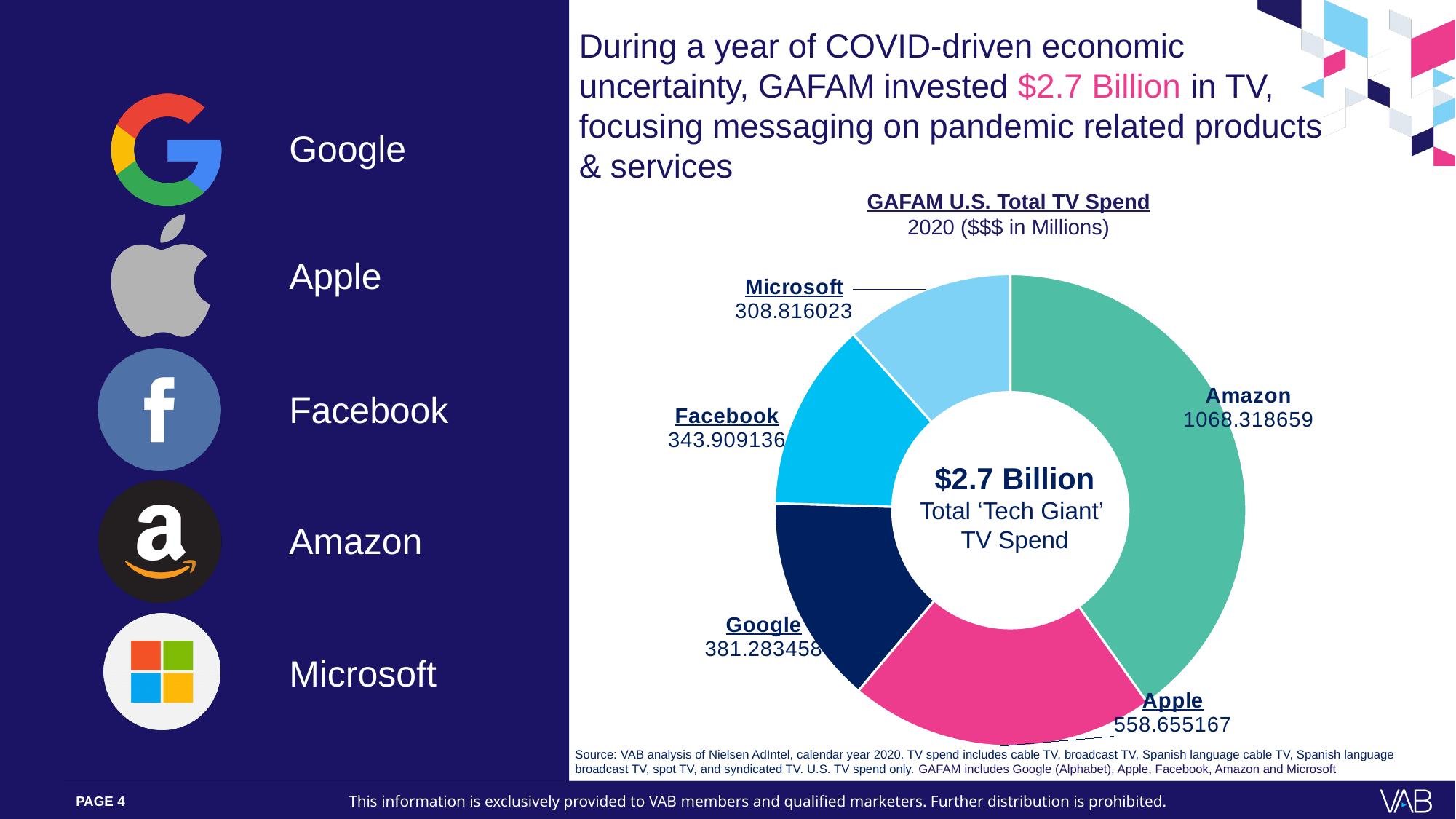
What is the value for Apple in the GAFAM U.S. Total TV Spend chart? 558.655167 Which company has the lowest TV spend in the GAFAM U.S. Total TV Spend chart? Microsoft How many companies are shown in the GAFAM U.S. Total TV Spend chart? 5 What is the value for Amazon in the GAFAM U.S. Total TV Spend chart? 1068.318659 What is the difference between Amazon's and Apple's values in the GAFAM U.S. Total TV Spend chart? 509.663492 What is the difference between Google's and Facebook's values in the GAFAM U.S. Total TV Spend chart? 37.374322 What is the value for Microsoft in the GAFAM U.S. Total TV Spend chart? 308.816023 Which is larger in the GAFAM U.S. Total TV Spend chart, Google or Facebook? Google Which company has the highest TV spend in the GAFAM U.S. Total TV Spend chart? Amazon What units does the subtitle of the GAFAM U.S. Total TV Spend chart say the values are in? $$$ in Millions What kind of chart is the GAFAM U.S. Total TV Spend chart? Donut (pie) chart What total is shown in the center of the GAFAM U.S. Total TV Spend chart? $2.7 Billion